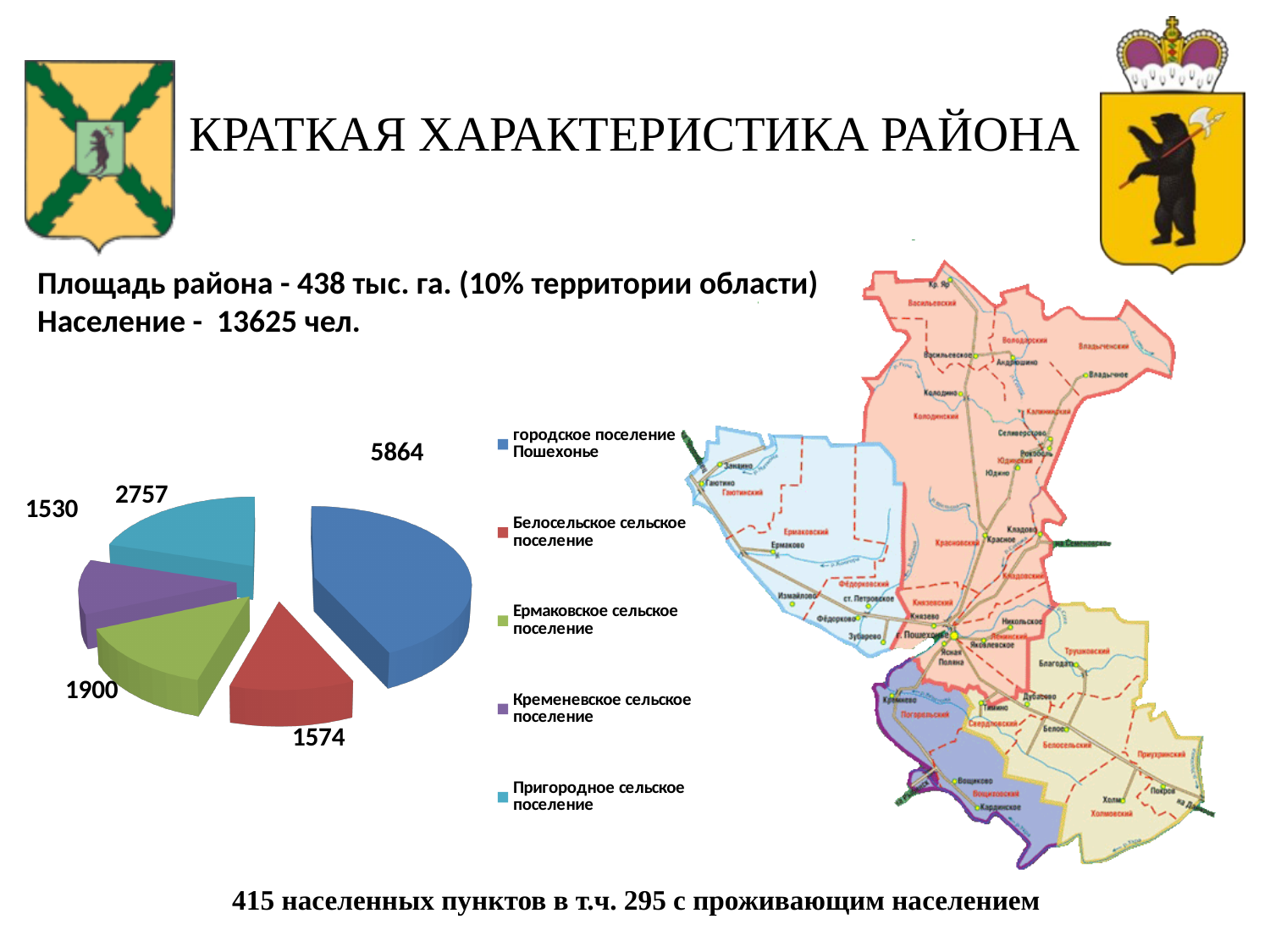
What is the value for Ермаковское сельское поселение in the pie chart? 1900 What is the value for Пригородное сельское поселение in the pie chart? 2757 What is the value for городское поселение Пошехонье in the pie chart? 5864 How many slices does the pie chart have? 5 Which is larger in the pie chart: Ермаковское сельское поселение or Белосельское сельское поселение? Ермаковское сельское поселение Which settlement has the smallest slice in the pie chart? Кременевское сельское поселение How many entries does the legend of the pie chart list? 5 What is the difference between the values for городское поселение Пошехонье and Пригородное сельское поселение? 3107 Which settlement has the largest slice in the pie chart? городское поселение Пошехонье What type of chart is shown on the slide? pie chart What is the value for Белосельское сельское поселение in the pie chart? 1574 What is the total of all slices in the pie chart? 13625